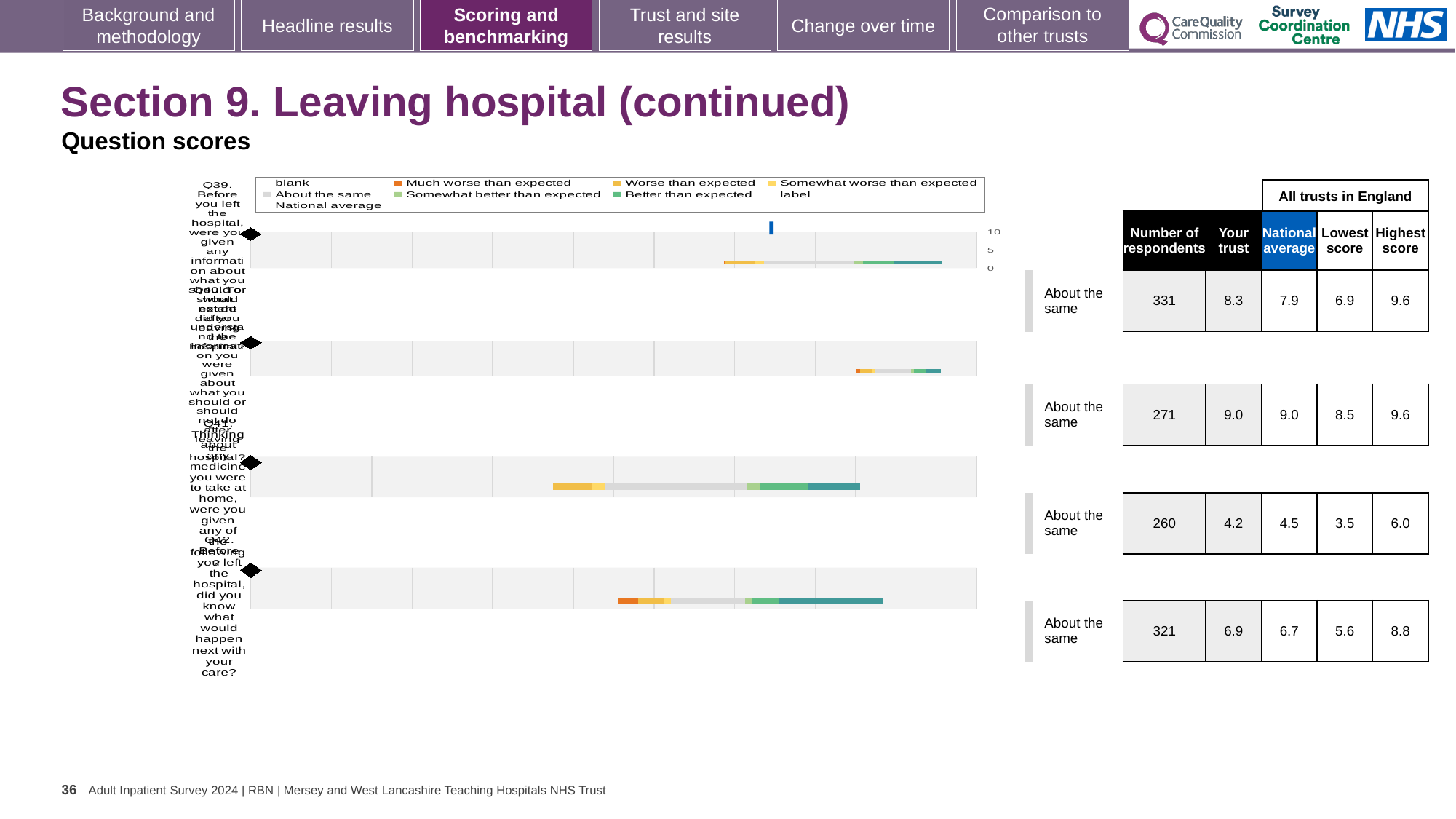
What is the difference between the 'Your trust' score and the national average for the fourth question row (Q42)? 0.2 What benchmark category is shown next to each of the four question rows? About the same Which question row has the highest 'Your trust' score? Q40 (second row), 9.0 What is the 'Your trust' score for the first question row (Q39)? 8.3 How many respondents answered the third question row (Q41)? 260 What kind of chart is shown on the slide? bar chart What is the lowest score among all trusts in England for the second question row (Q40)? 8.5 For the third question row (Q41), is the 'Your trust' score or the national average larger? National average (4.5) Which question row has the lowest 'Your trust' score? Q41 (third row), 4.2 How many question rows (bars) are plotted in the chart? 4 What is the national average score for the first question row (Q39)? 7.9 What is the highest score among all trusts in England for the fourth question row (Q42)? 8.8